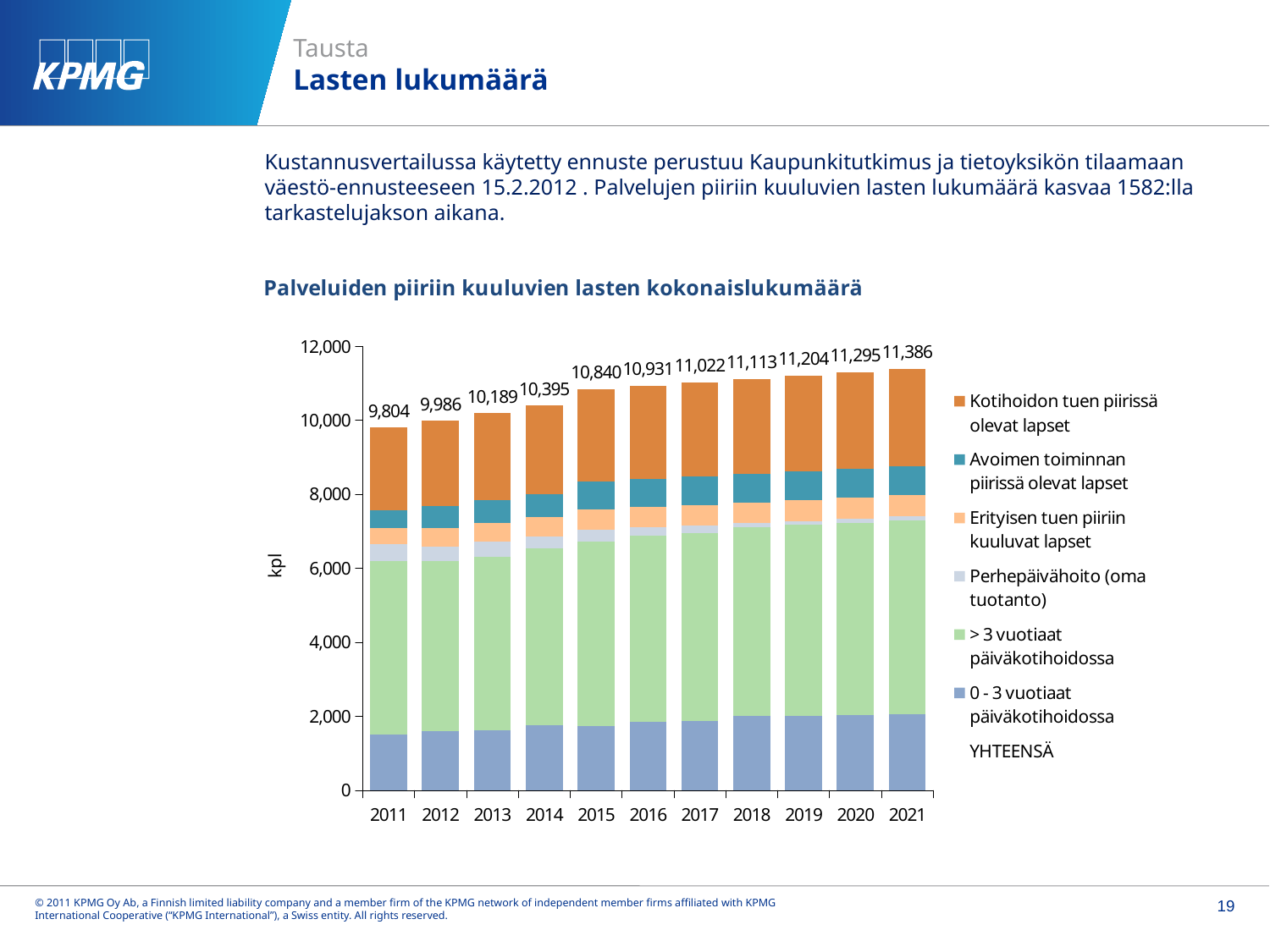
How many entries does the legend list? 7 What is the difference between the total for 2021 and the total for 2011? 1,582 Do the total values rise or fall from 2011 to 2021? Rise Which is larger, the total for 2014 or the total for 2015? 2015 What kind of chart is shown on the slide? Stacked bar chart Which year has the lowest total number of children? 2011 How many years are shown on the x axis? 11 What is the total number of children shown for 2021? 11,386 What is the total number of children shown for 2015? 10,840 What is the total number of children shown for 2011? 9,804 Which year has the highest total number of children? 2021 Is the value for '0 - 3 vuotiaat päiväkotihoidossa' in 2011 greater or less than 2,000? less